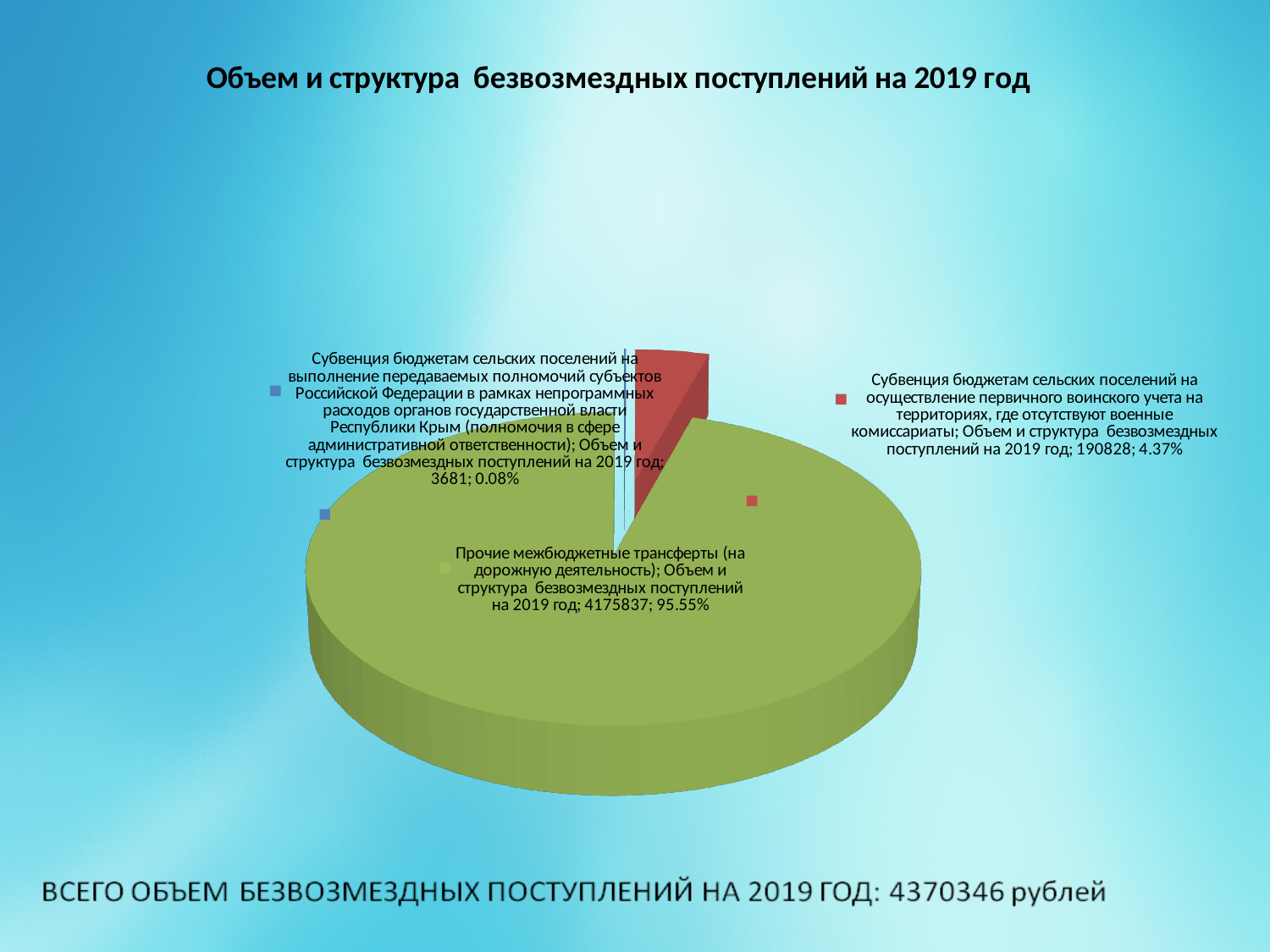
What is the value for the subvention for administrative responsibility powers ("полномочия в сфере административной ответственности")? 3681 What share of the pie does "Прочие межбюджетные трансферты (на дорожную деятельность)" represent? 95.55% How many slices does the pie chart have? 3 What is the value for "Прочие межбюджетные трансферты (на дорожную деятельность)"? 4175837 What share of the pie does the subvention for administrative responsibility powers represent? 0.08% What is the difference between the value for the military registration subvention (190828) and the administrative responsibility subvention (3681)? 187147 Which category has the smallest slice of the pie? Субвенция бюджетам сельских поселений на выполнение передаваемых полномочий субъектов Российской Федерации (полномочия в сфере административной ответственности) What kind of chart is shown on the slide? Pie chart Which category has the largest slice of the pie? Прочие межбюджетные трансферты (на дорожную деятельность) What is the value for the subvention for primary military registration ("Субвенция бюджетам сельских поселений на осуществление первичного воинского учета")? 190828 What is the title of the chart? Объем и структура безвозмездных поступлений на 2019 год What share of the pie does the subvention for primary military registration represent? 4.37%